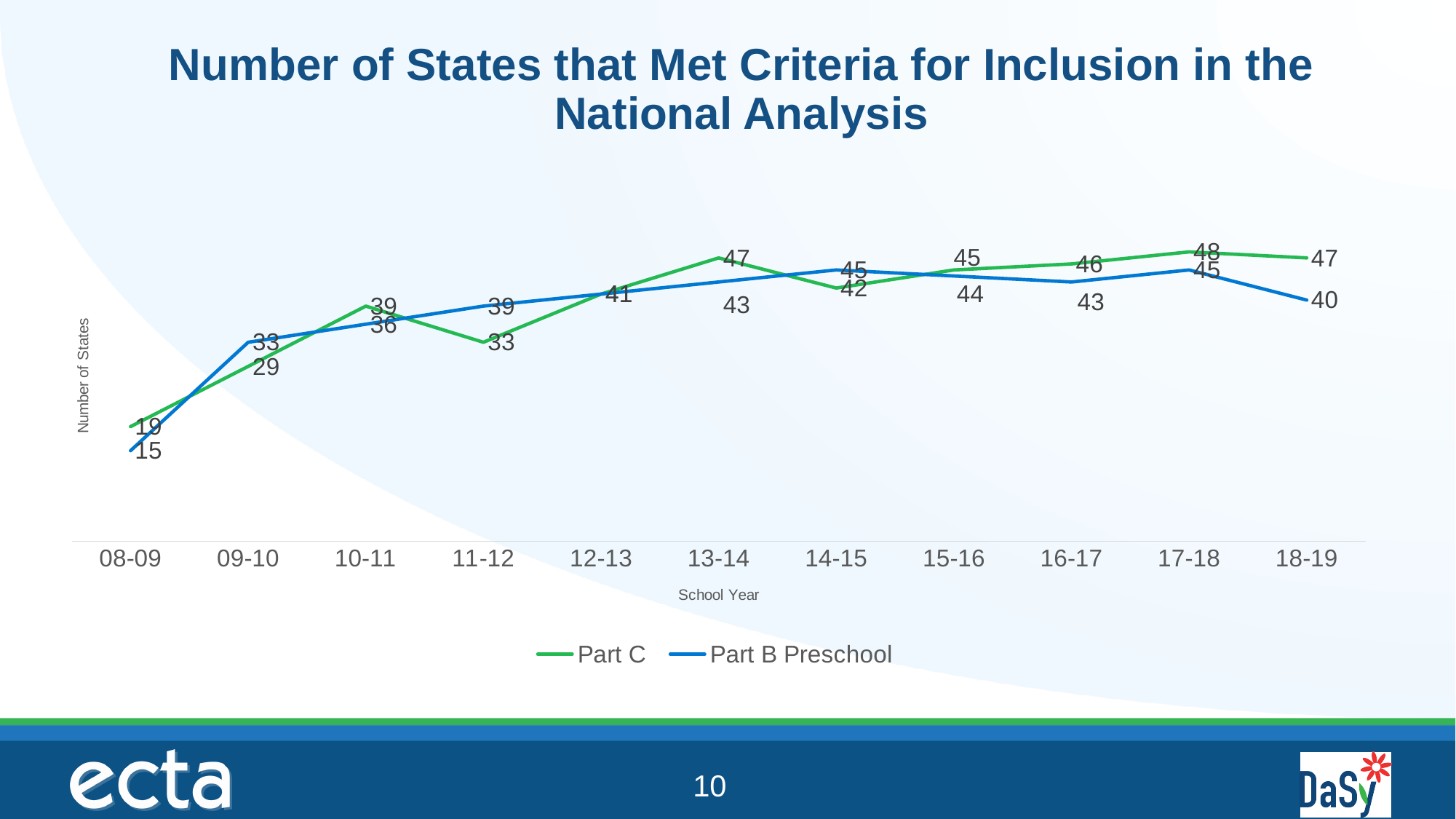
What is the value for Part C in 08-09? 19 What is the value for Part B Preschool in 13-14? 43 In 11-12, which series has the larger value, Part C or Part B Preschool? Part B Preschool What is the value for Part B Preschool in 18-19? 40 What kind of chart is shown on the slide? line chart In which school year does Part C reach its highest value? 17-18 What colour is the Part C line? green Does the Part B Preschool line rise or fall from 17-18 to 18-19? fall What is the difference between Part C and Part B Preschool in 18-19? 7 In which school year does Part B Preschool have its lowest value? 08-09 How many series does the legend list? 2 How many school years are plotted along the x axis? 11